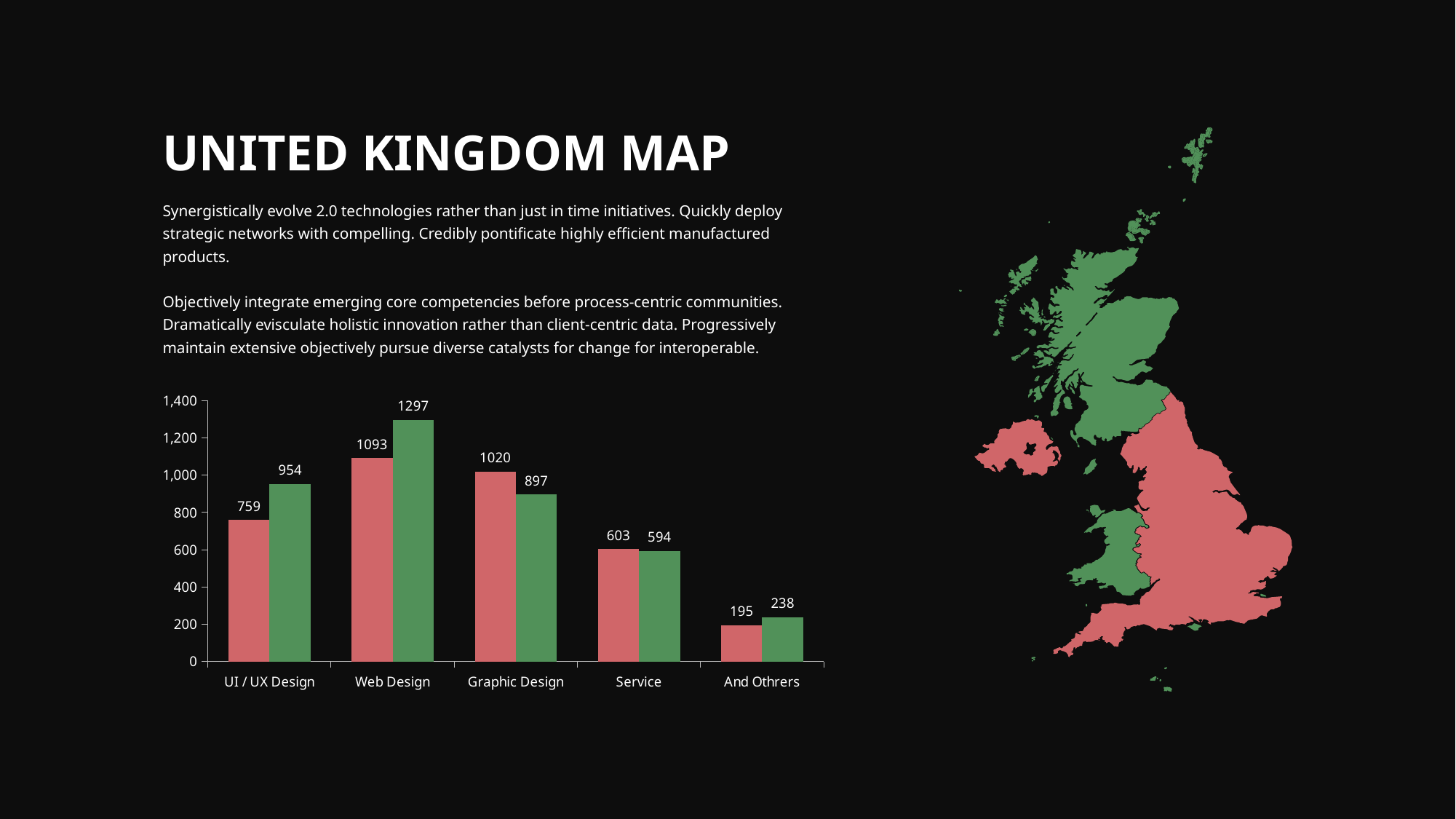
What is the difference between the red and green bars for Graphic Design? 123 What is the difference between the green and red bars for Web Design? 204 Which is larger for Graphic Design, the red bar or the green bar? the red bar Which category has the highest green bar? Web Design Which category has the lowest red bar? And Othrers What two colours are used for the bars in the chart? red and green How many categories are shown on the x axis? 5 What is the value of the green bar for UI / UX Design? 954 What is the value of the red bar for Web Design? 1093 What is the value of the green bar for And Othrers? 238 Is the red bar for Service greater or less than 400? greater What kind of chart is shown on the slide? bar chart